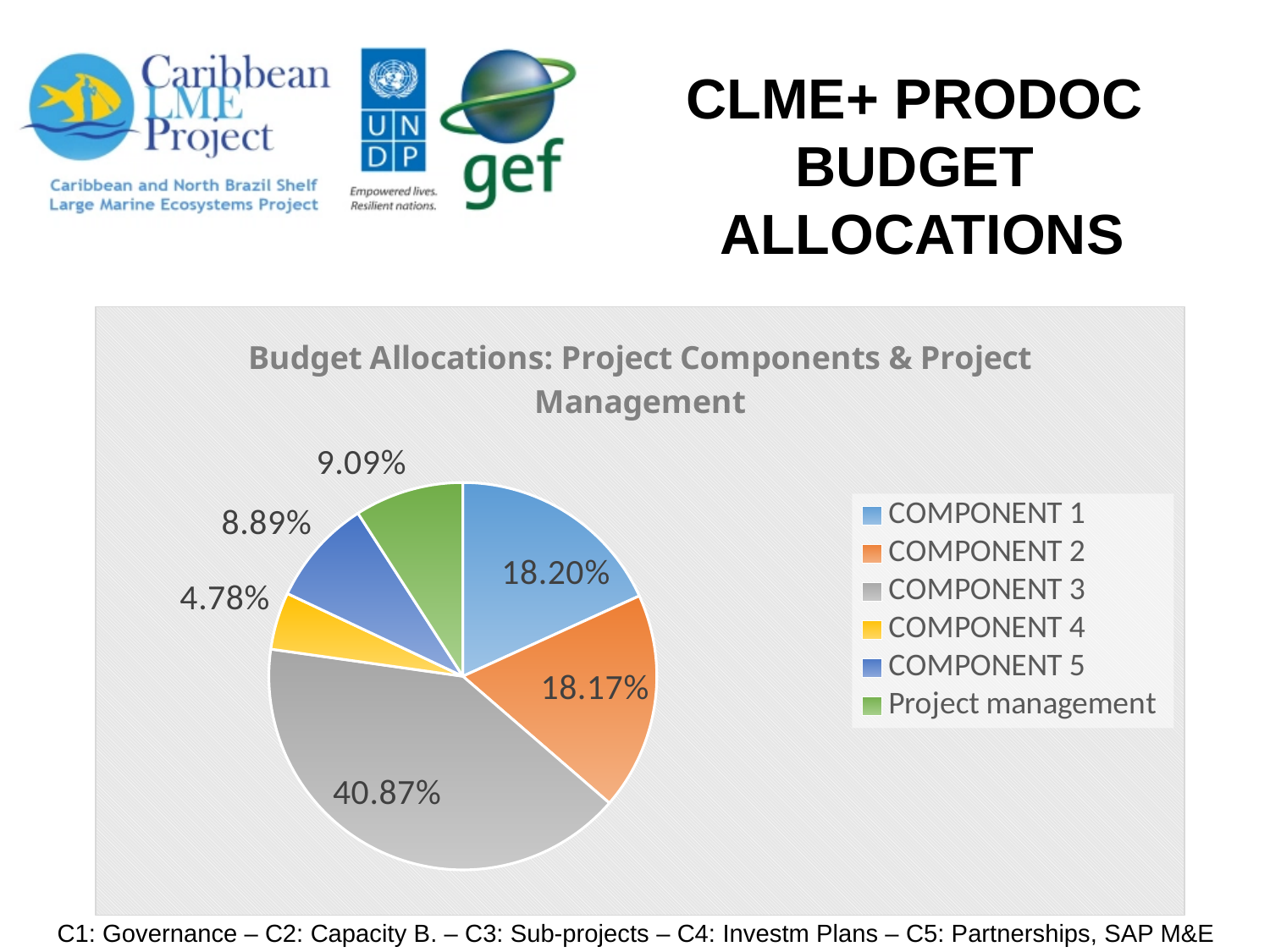
What share of the budget is allocated to COMPONENT 4? 4.78% What share of the budget is allocated to Project management? 9.09% What kind of chart is shown on the slide? Pie chart What share of the budget is allocated to COMPONENT 3? 40.87% What share of the budget is allocated to COMPONENT 1? 18.20% What is the difference in percentage points between the shares of COMPONENT 3 and COMPONENT 2? 22.70% What is the title of the pie chart? Budget Allocations: Project Components & Project Management Which category receives the largest share of the budget? COMPONENT 3 What share of the budget is allocated to COMPONENT 5? 8.89% Which receives a larger share of the budget, COMPONENT 3 or COMPONENT 2? COMPONENT 3 Which category receives the smallest share of the budget? COMPONENT 4 How many categories does the legend of the pie chart list? 6